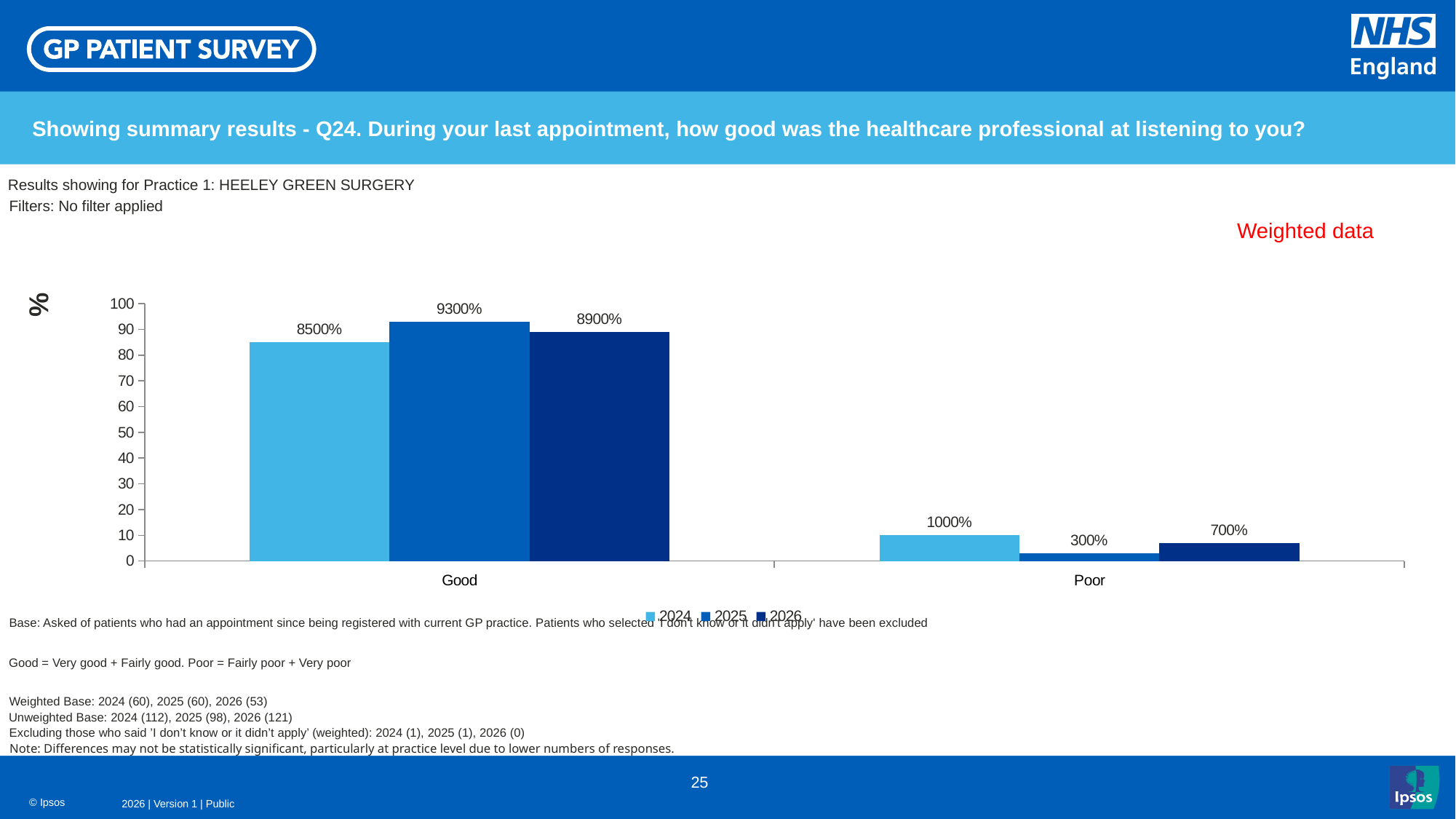
What is the data label shown for the 2025 bar in the Good category? 9300% Which year has the highest bar in the Good category? 2025 What is the data label shown for the 2024 bar in the Good category? 8500% What is the label on the y axis of the chart? % What is the data label shown for the 2026 bar in the Poor category? 700% What kind of chart is shown on the slide? bar chart Which is larger in the Good category: the 2024 bar or the 2026 bar? 2026 What is the data label shown for the 2025 bar in the Poor category? 300% How many series does the legend list? 3 How many categories are shown on the x axis? 2 Is the 2024 bar in the Poor category greater or less than 20 on the y axis? less Which year has the lowest bar in the Poor category? 2025